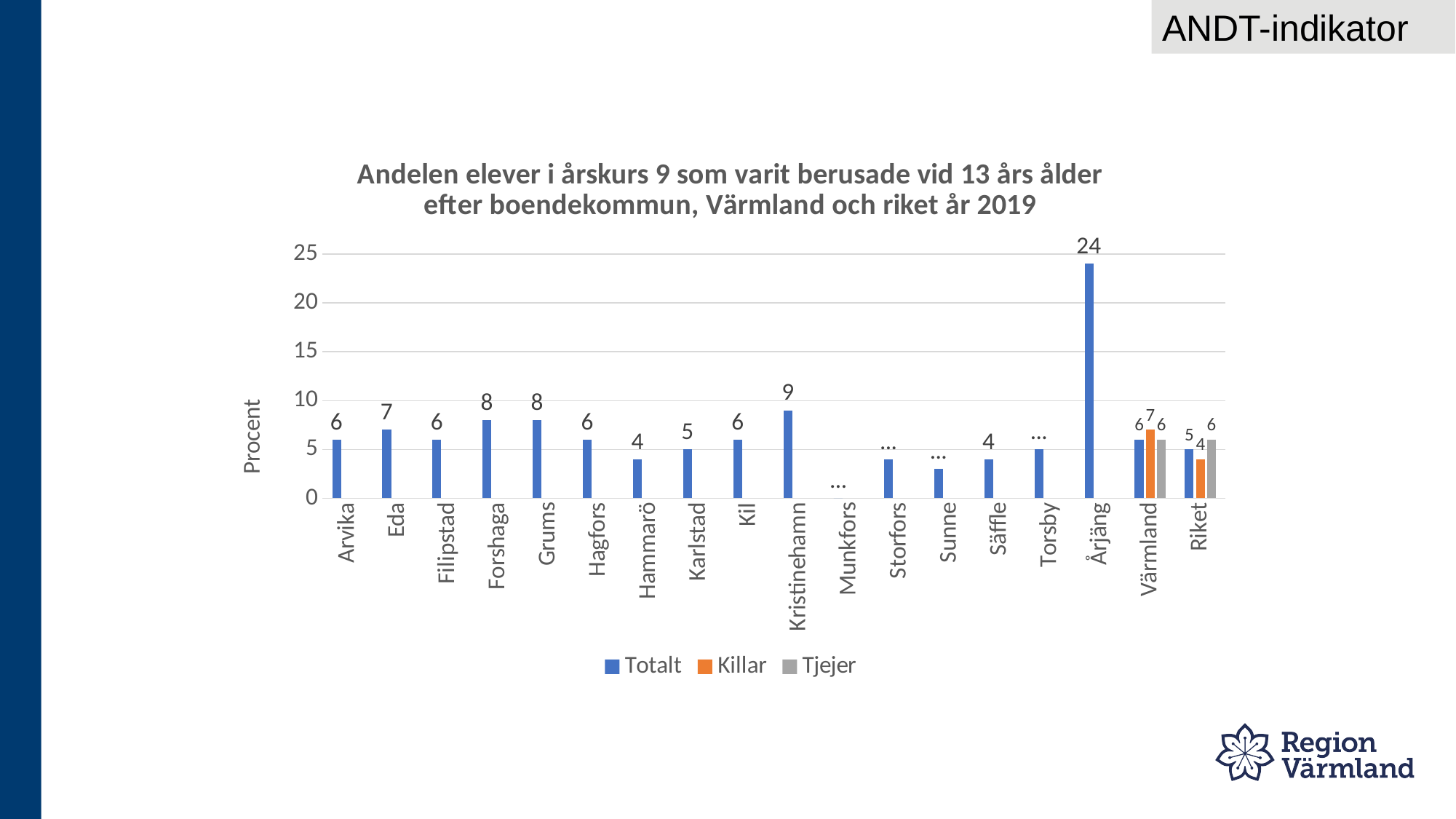
What is the Tjejer value for Riket? 6 What is the label on the vertical axis? Procent Is the Totalt value for Sunne greater or less than 5? less What is the Killar value for Värmland? 7 What is the difference between the Totalt values for Årjäng and Kristinehamn? 15 Which has the larger Totalt value, Eda or Hammarö? Eda What kind of chart is shown on the slide? bar chart How many categories are shown on the x axis? 18 What is the Totalt value for Årjäng? 24 What is the Totalt value for Kristinehamn? 9 How many series does the legend list? 3 Which category has the highest Totalt value? Årjäng